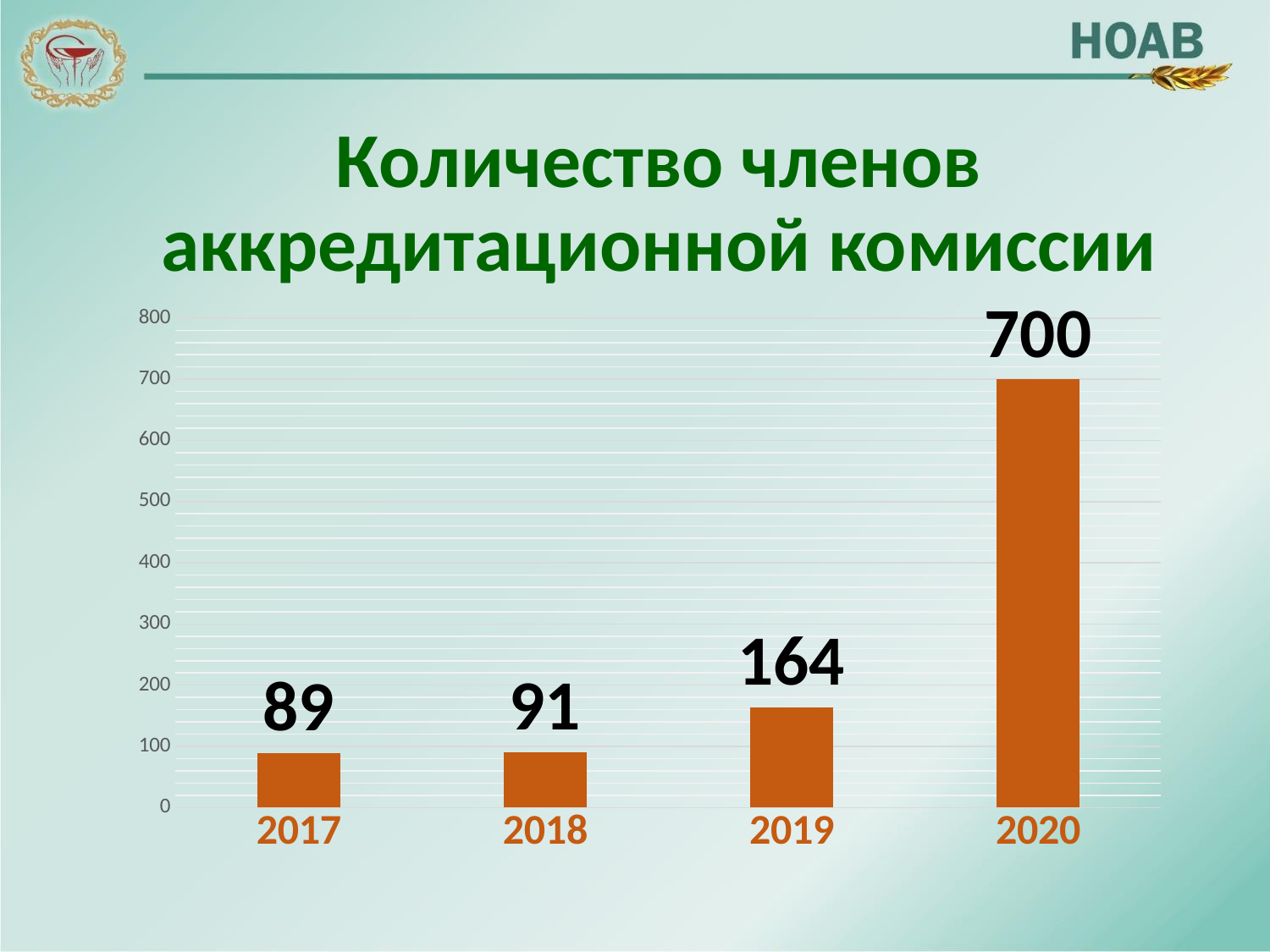
Which year has the highest value? 2020 What is the difference between the values for 2018 and 2017? 2 What kind of chart is shown on the slide? bar chart What is the value for 2019? 164 What is the value for 2020? 700 Do the values rise or fall from 2017 to 2020? rise Which is larger, the value for 2019 or the value for 2018? 2019 Is the value for 2019 greater or less than 100? greater What is the value for 2017? 89 Which year has the lowest value? 2017 What is the difference between the values for 2020 and 2019? 536 How many years are shown on the x axis? 4